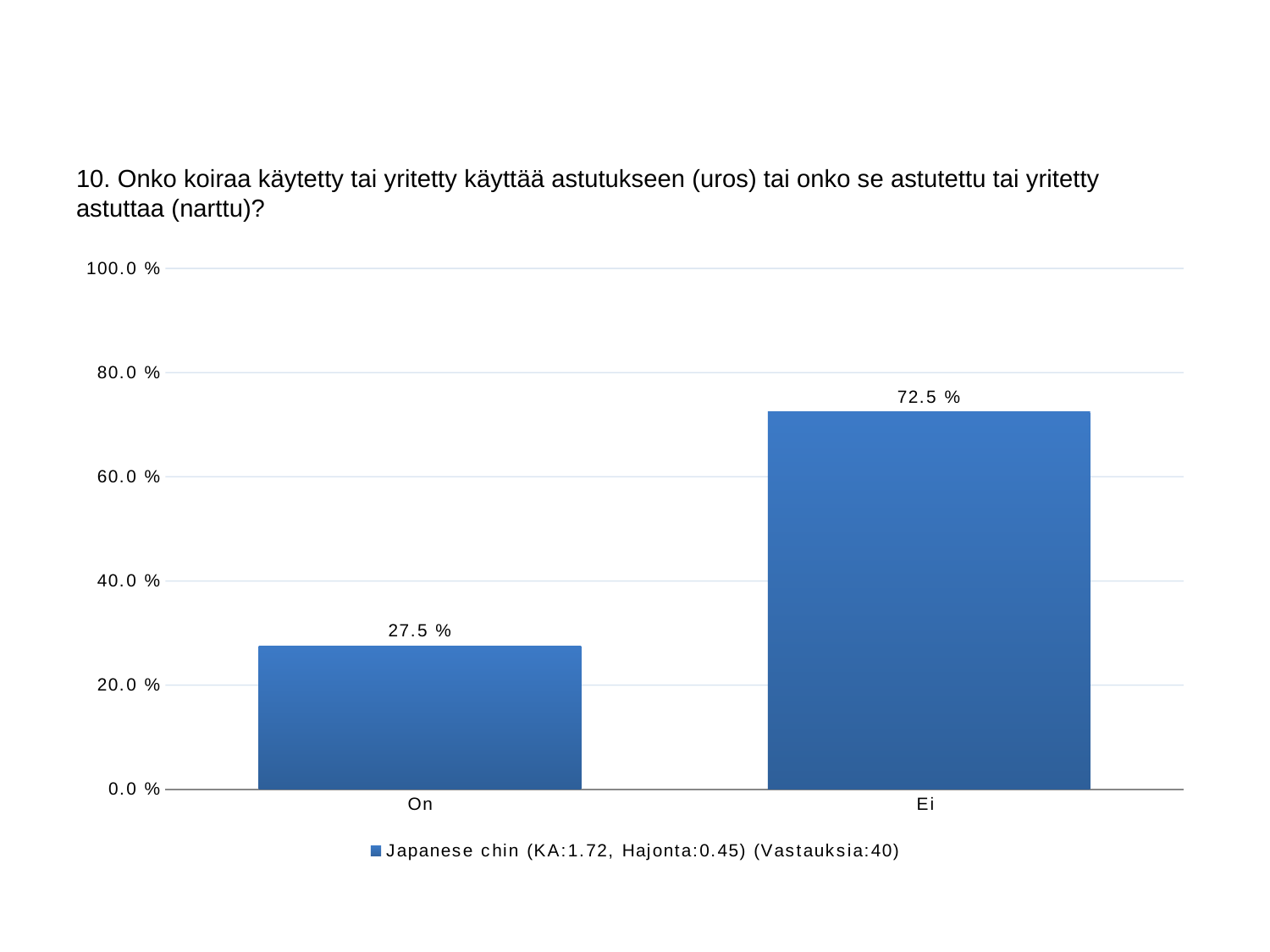
Which is larger, the value for "On" or the value for "Ei"? Ei Which category has the highest value? Ei What is the value for "On"? 27.5 % How many responses (Vastauksia) does the legend entry state? 40 How many categories are shown on the x axis? 2 What is the value for "Ei"? 72.5 % How many series does the legend list? 1 Is the value for "Ei" greater or less than 60.0 %? greater Which category has the lowest value? On Is the value for "On" greater or less than 40.0 %? less What is the difference between the values for "Ei" and "On"? 45.0 % What kind of chart is shown on the slide? bar chart